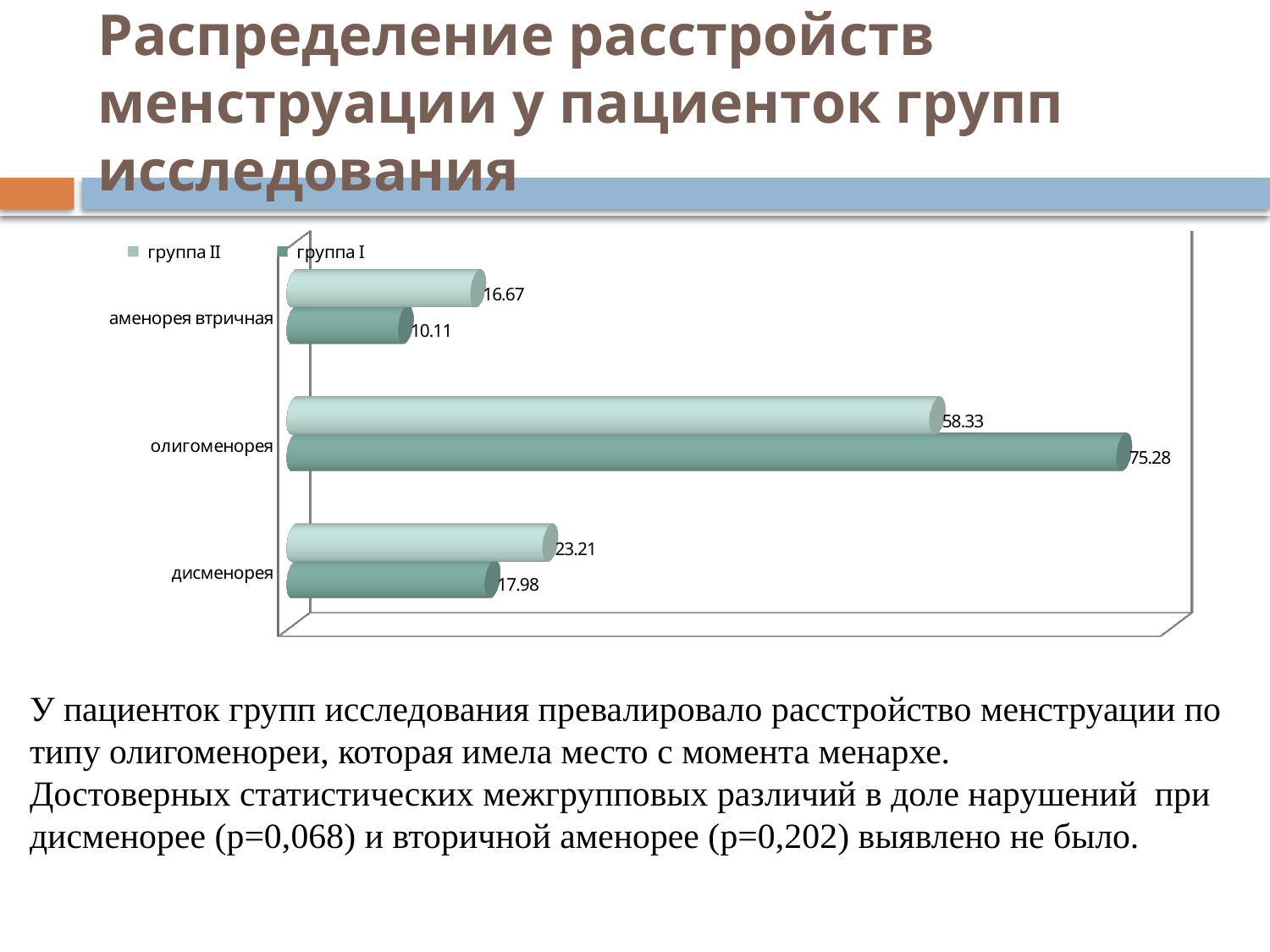
What is the value for группа I for аменорея втричная? 10.11 Which category has the lowest value for группа II? аменорея втричная What is the value for группа I for олигоменорея? 75.28 What kind of chart is shown on the slide? bar chart What is the value for группа II for олигоменорея? 58.33 Which series is shown with the darker bars? группа I How many series does the legend list? 2 What is the difference between группа I and группа II for олигоменорея? 16.95 How many categories are shown on the chart? 3 What is the value for группа II for дисменорея? 23.21 Which is larger for дисменорея: группа I or группа II? группа II Which category has the highest value for группа I? олигоменорея